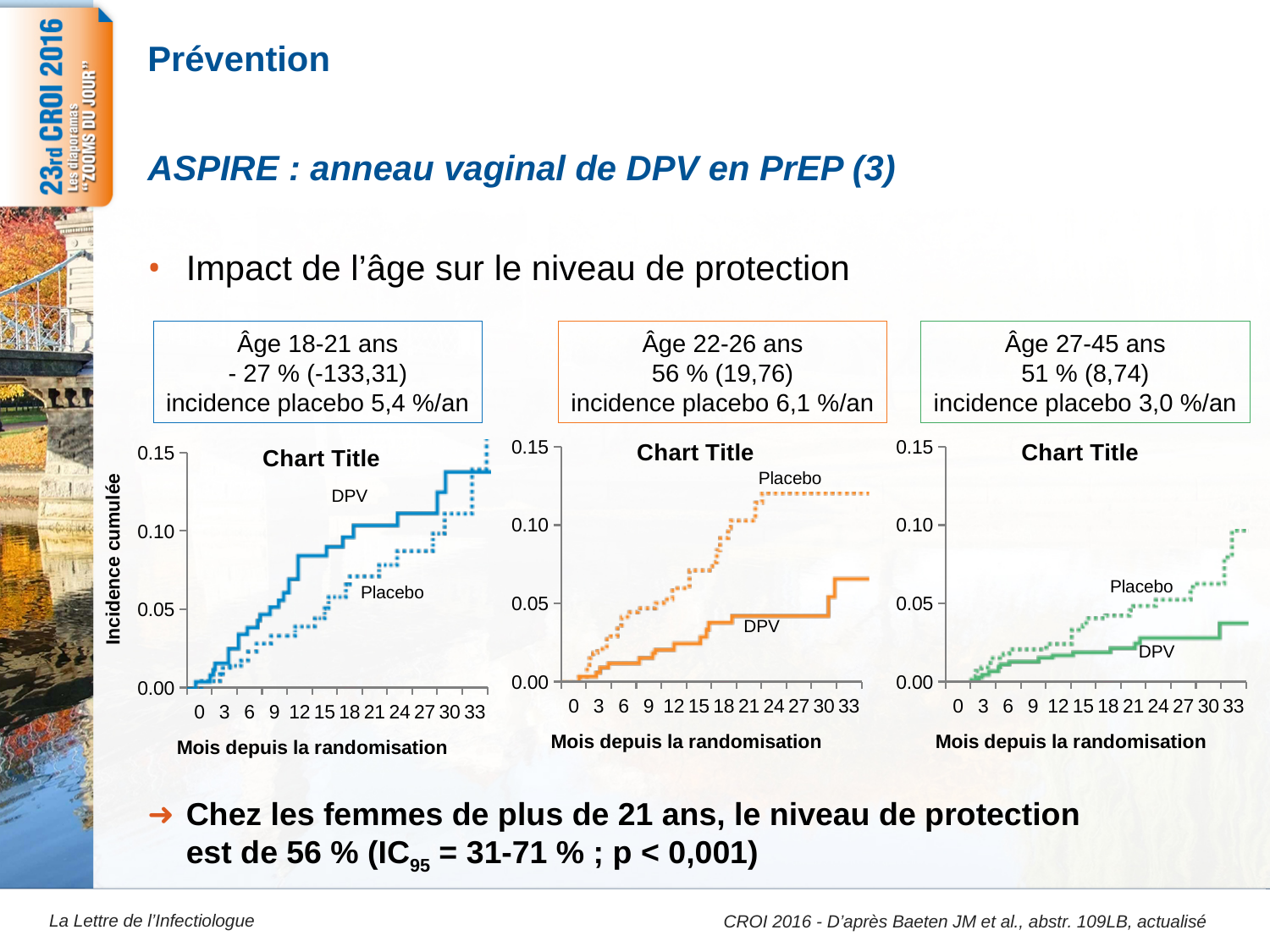
In the left chart (Âge 18-21 ans), which series is higher at month 18, DPV or Placebo? DPV In the right chart (Âge 27-45 ans), is the DPV value at month 33 greater or less than 0.05? less How many tick labels are shown on the x axis of the right chart (Âge 27-45 ans)? 12 In the middle chart (Âge 22-26 ans), do the Placebo values rise or fall as months since randomisation increase? rise What kind of chart is the left chart (Âge 18-21 ans)? line chart In the middle chart (Âge 22-26 ans), which series is higher at month 24, Placebo or DPV? Placebo What is the x-axis label of the middle chart (Âge 22-26 ans)? Mois depuis la randomisation In the middle chart (Âge 22-26 ans), how many series are plotted? 2 What is the highest tick value shown on the y axis of the left chart (Âge 18-21 ans)? 0.15 In the right chart (Âge 27-45 ans), which series is higher at month 30, Placebo or DPV? Placebo In the middle chart (Âge 22-26 ans), is the Placebo value at month 33 greater or less than 0.10? greater In the left chart (Âge 18-21 ans), is the DPV value at month 33 greater or less than 0.10? greater